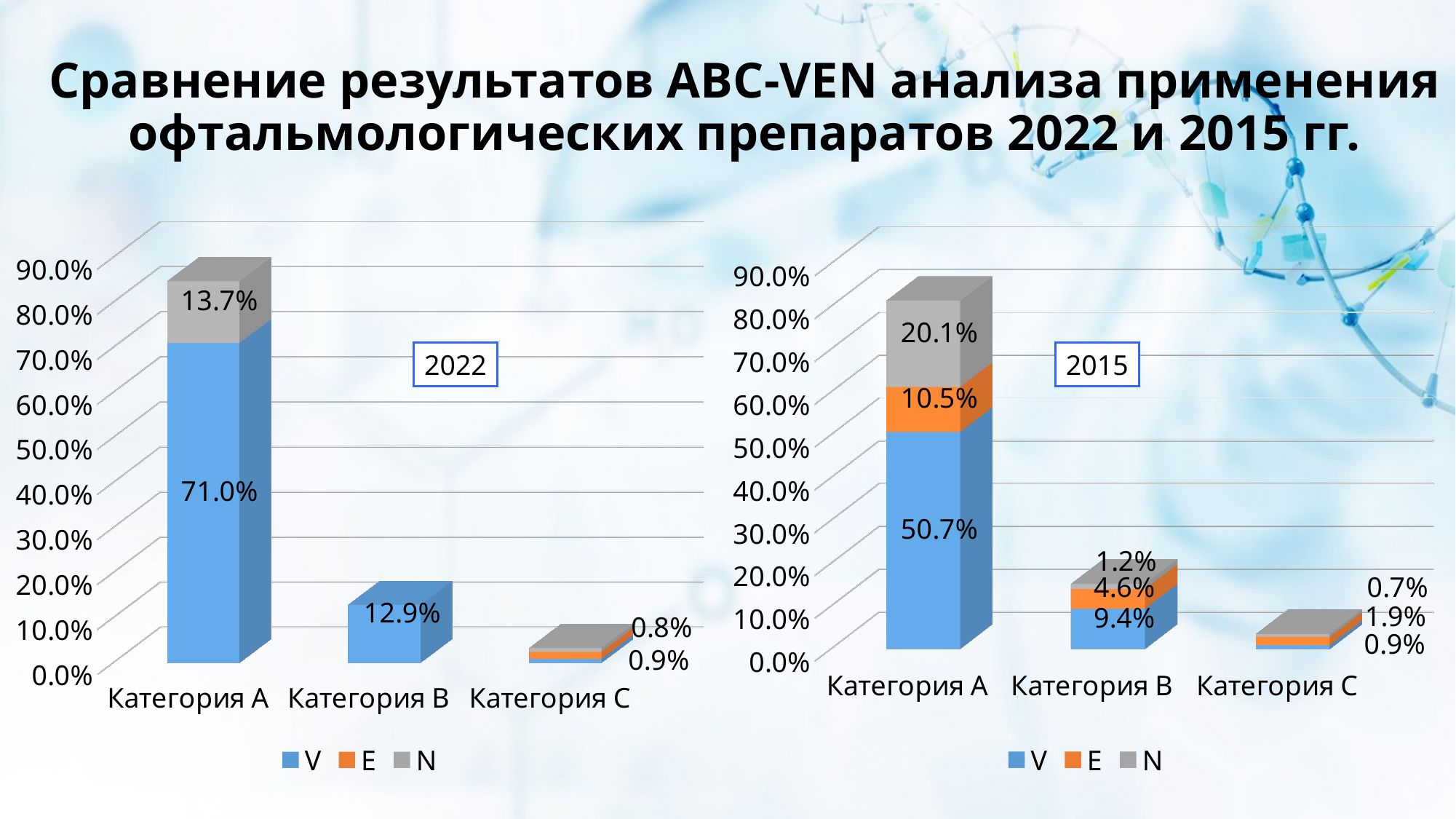
What type of chart is the 2015 chart? Stacked bar chart What is the difference between the V value for Категория A in the 2022 chart and the V value for Категория A in the 2015 chart? 20.3% In the 2015 chart, what is the value of series N for Категория A? 20.1% In the 2015 chart, which category has the tallest stacked bar? Категория A In the 2015 chart, what is the total of the stacked bar for Категория A? 81.3% In the 2015 chart, what is the value of series V for Категория B? 9.4% In the 2022 chart, what is the value of series N for Категория A? 13.7% In the 2022 chart, what is the value of series V for Категория A? 71.0% How many series does the legend of the 2022 chart list? 3 In the 2022 chart, what is the value of series V for Категория B? 12.9% In the 2015 chart, what is the value of series E for Категория A? 10.5% In the 2015 chart, what is the total of the stacked bar for Категория B? 15.2%